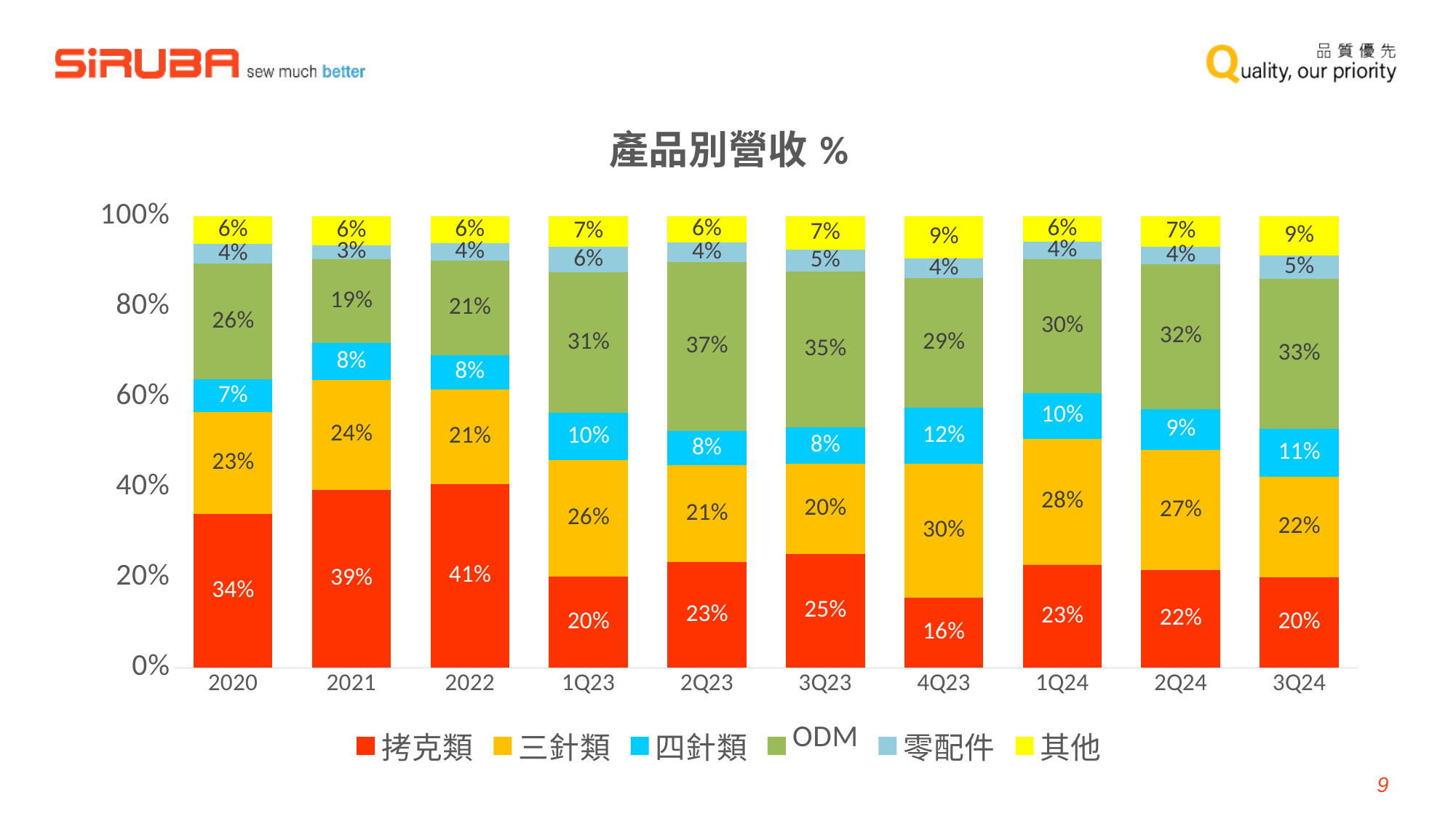
What is the value for 四針類 in 3Q24? 11% What is the value for ODM in 2Q23? 37% What is the value for 拷克類 in 2022? 41% What is the difference between the ODM share in 2Q23 and in 2021? 18% In which category is the 拷克類 share the highest? 2022 What type of chart is shown on the slide? Stacked bar chart In which category is the 拷克類 share the lowest? 4Q23 How many categories are shown on the x axis? 10 How many series does the legend list? 6 What is the value for 三針類 in 4Q23? 30% Which is larger in 1Q24: the 三針類 share or the 拷克類 share? 三針類 What is the title of the chart? 產品別營收 %